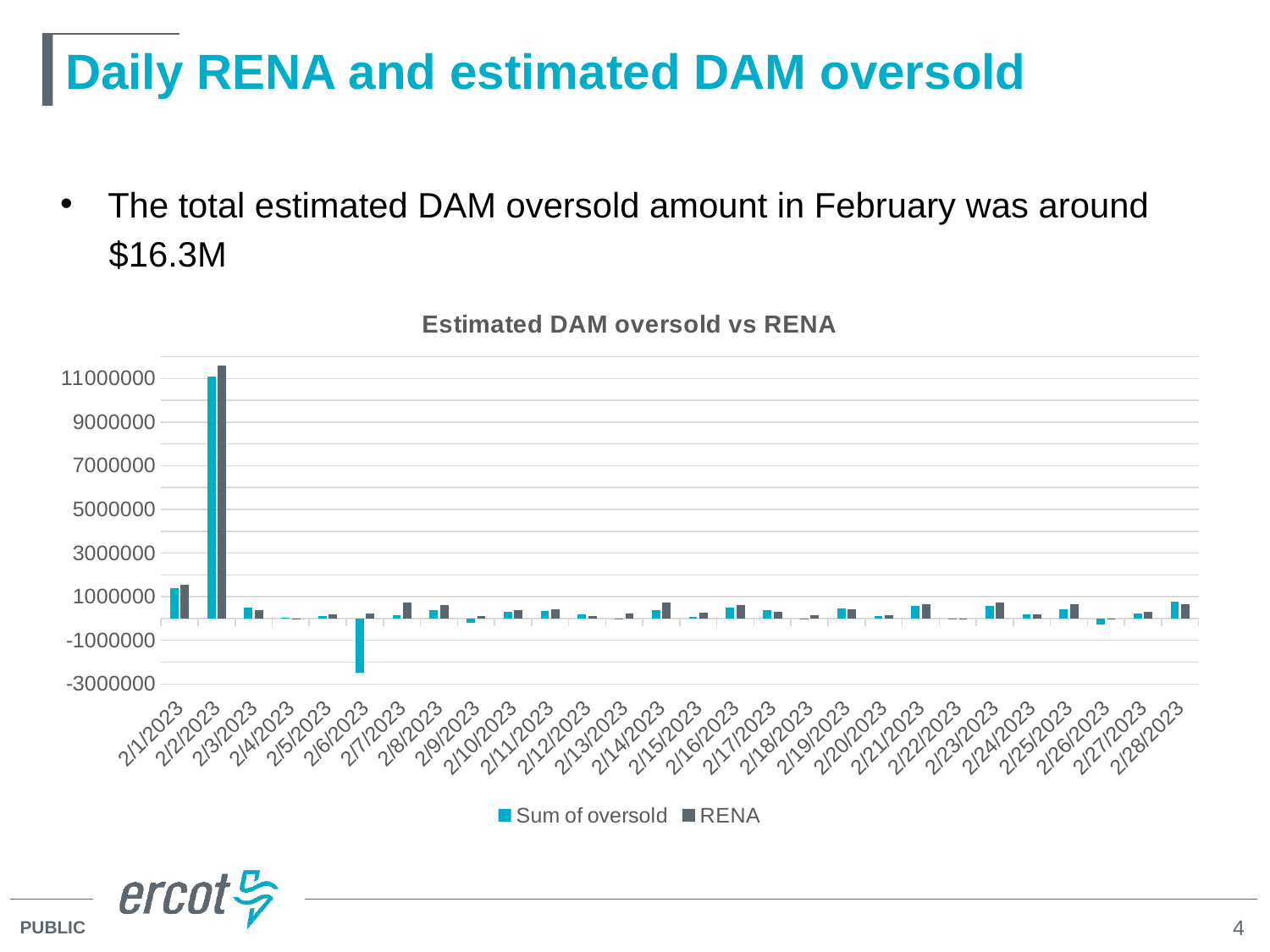
On which date is the Sum of oversold value lowest? 2/6/2023 Is the Sum of oversold value for 2/1/2023 greater or less than 1000000? greater What kind of chart is shown on the slide? Bar chart How many series does the chart's legend list? 2 What is the title of the chart? Estimated DAM oversold vs RENA On which date is the RENA value highest? 2/2/2023 How many dates are shown along the x axis of the chart? 28 Which series is shown in the darker grey bars? RENA On which date is the Sum of oversold value highest? 2/2/2023 Is the Sum of oversold value for 2/6/2023 greater or less than -1000000? less Is the Sum of oversold value for 2/2/2023 greater or less than 9000000? greater Which is larger for 2/1/2023: the Sum of oversold value or the RENA value? RENA